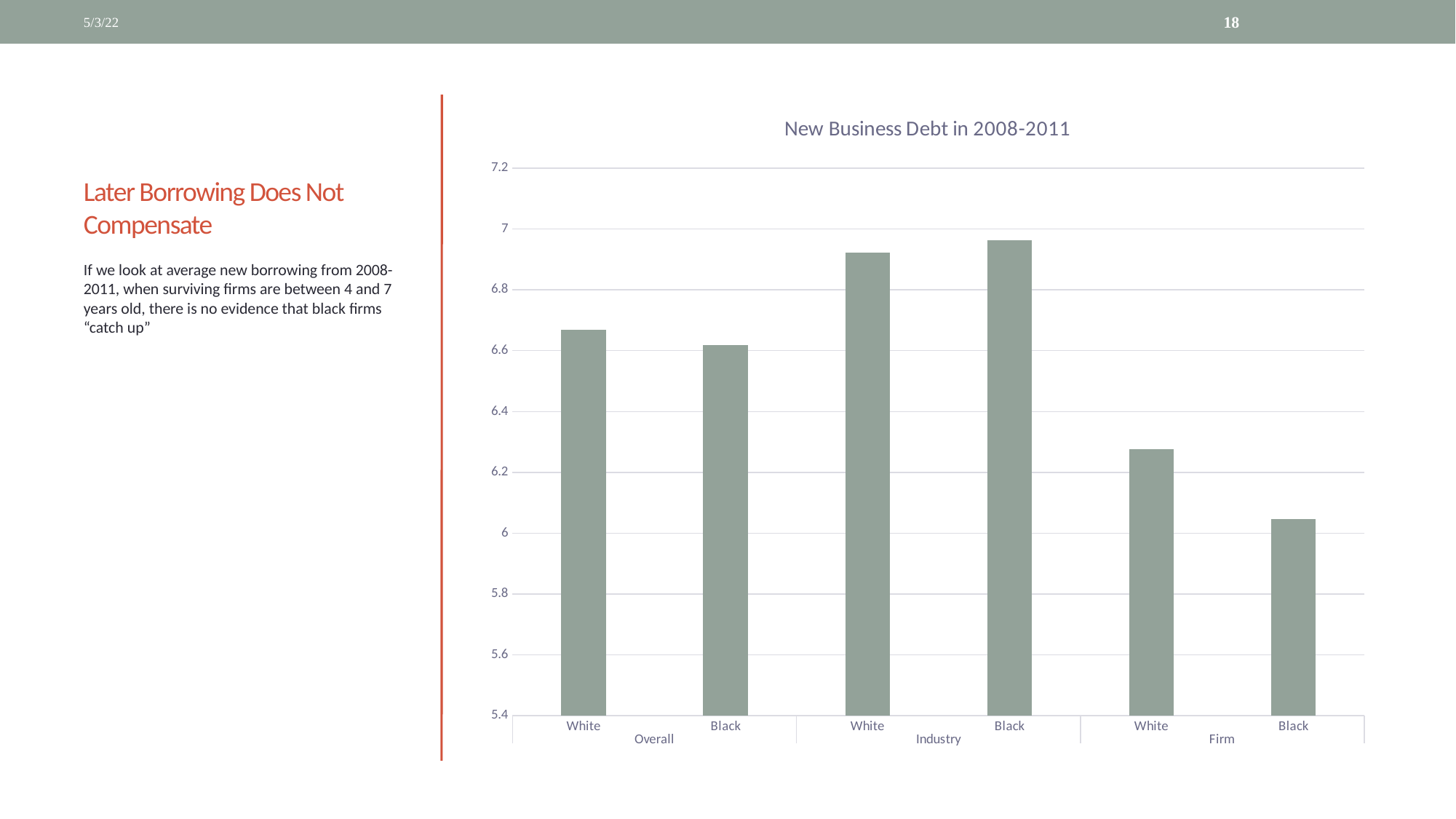
Which bar has the lowest value in the chart? Black (Firm) Which is larger: the value for Black in the Industry group or the value for Black in the Firm group? Black (Industry) Is the value for White in the Firm group greater or less than 6.2? greater How many bars are plotted in the chart? 6 Is the value for White in the Overall group greater or less than 6.6? greater Is the value for Black in the Industry group greater or less than 7? less What is the title of the chart? New Business Debt in 2008-2011 Which is larger: the value for White in the Overall group or the value for White in the Firm group? White (Overall) What are the three group labels shown along the x axis? Overall, Industry, Firm What kind of chart is shown on the slide? bar chart